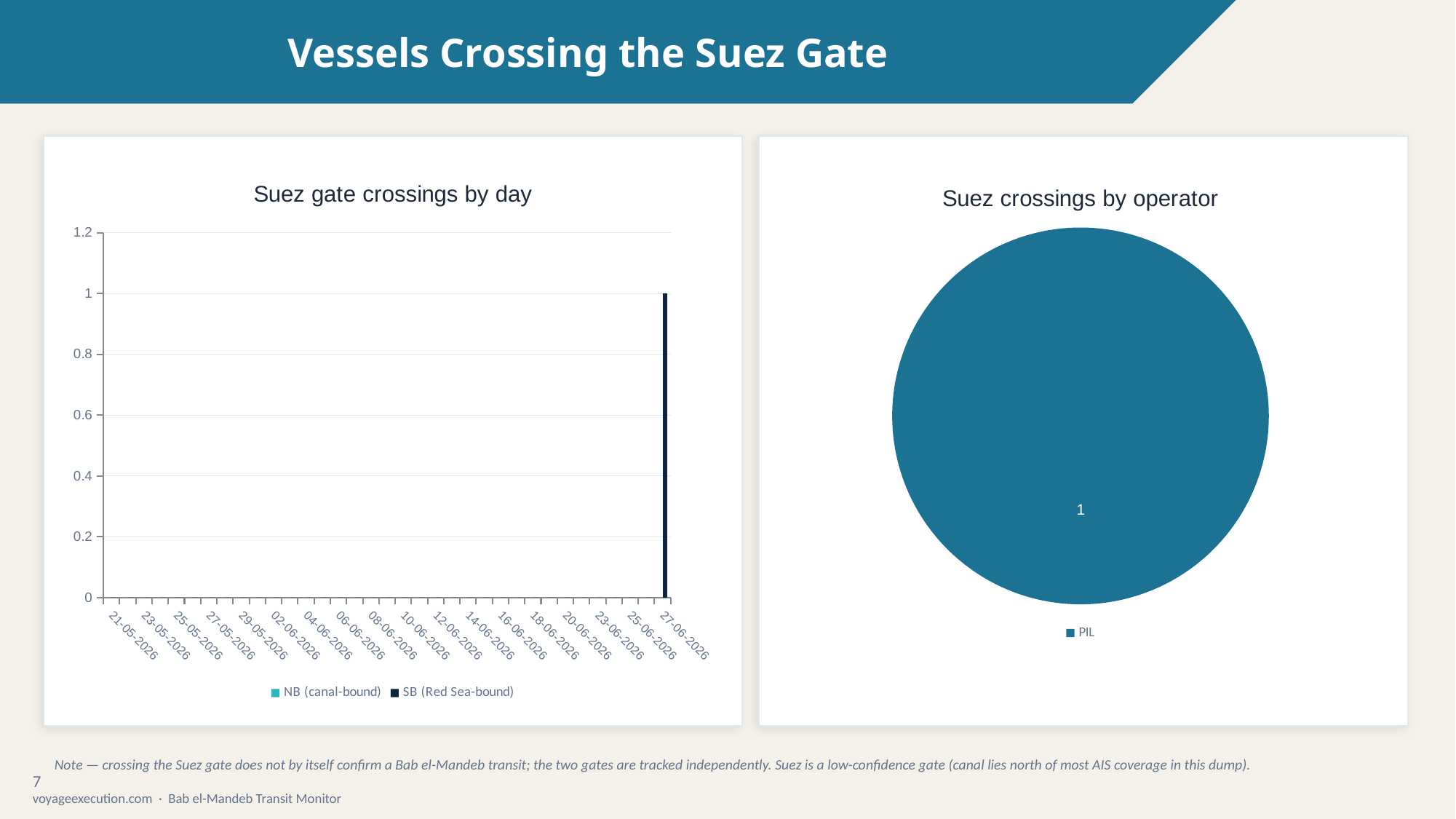
In the 'Suez crossings by operator' pie chart, which operator is listed in the legend? PIL In the 'Suez gate crossings by day' chart, which date has the highest SB (Red Sea-bound) value? 27-06-2026 In the 'Suez gate crossings by day' chart, is the SB (Red Sea-bound) value on 27-06-2026 greater or less than 0.6? greater In the 'Suez gate crossings by day' chart, what are the two legend entries? NB (canal-bound) and SB (Red Sea-bound) What kind of chart is the left chart, 'Suez gate crossings by day'? bar chart What kind of chart is the right chart, 'Suez crossings by operator'? pie chart In the 'Suez gate crossings by day' chart, what is the SB (Red Sea-bound) value on 27-06-2026? 1 In the 'Suez crossings by operator' pie chart, what is the value shown for PIL? 1 How many slices does the 'Suez crossings by operator' pie chart have? 1 In the 'Suez crossings by operator' pie chart, what share of the pie does PIL represent? 100% In the 'Suez gate crossings by day' chart, how many series does the legend list? 2 In the 'Suez gate crossings by day' chart, which series has the larger value on 27-06-2026, NB (canal-bound) or SB (Red Sea-bound)? SB (Red Sea-bound)